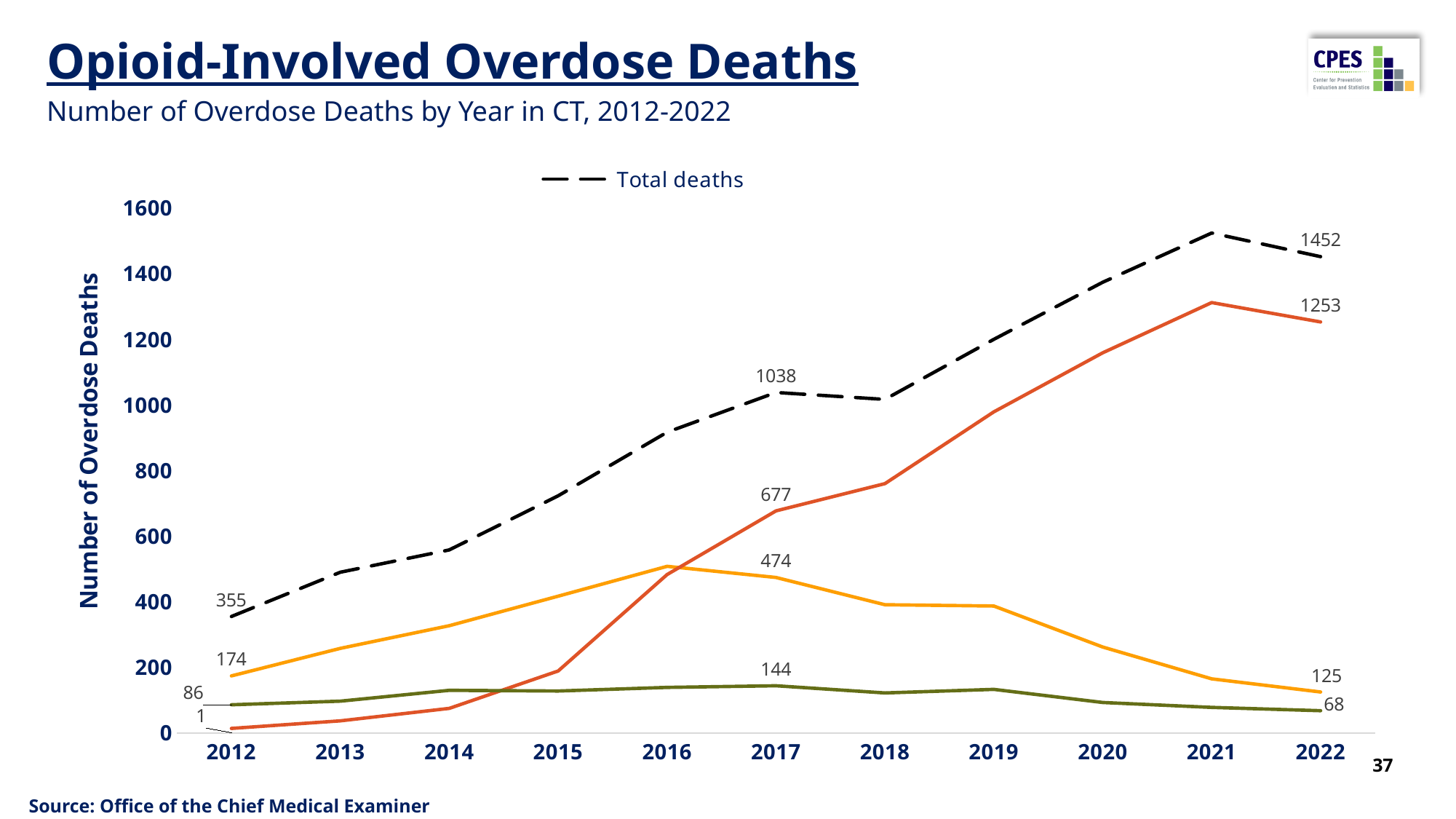
How many years are shown on the x axis? 11 By how much did Total deaths increase from 2012 to 2022? 1097 What is the value of Total deaths in 2017? 1038 In 2022, which is larger: the red line or the orange line? the red line Do Total deaths rise or fall from 2012 to 2021? rise What is the value of the red line in 2022? 1253 Is the value of Total deaths in 2016 greater or less than 800? greater What is the value of Total deaths in 2012? 355 What is the value of the orange line in 2017? 474 What is the value of Total deaths in 2022? 1452 In which year do Total deaths reach their highest point? 2021 What kind of chart is shown on the slide? line chart